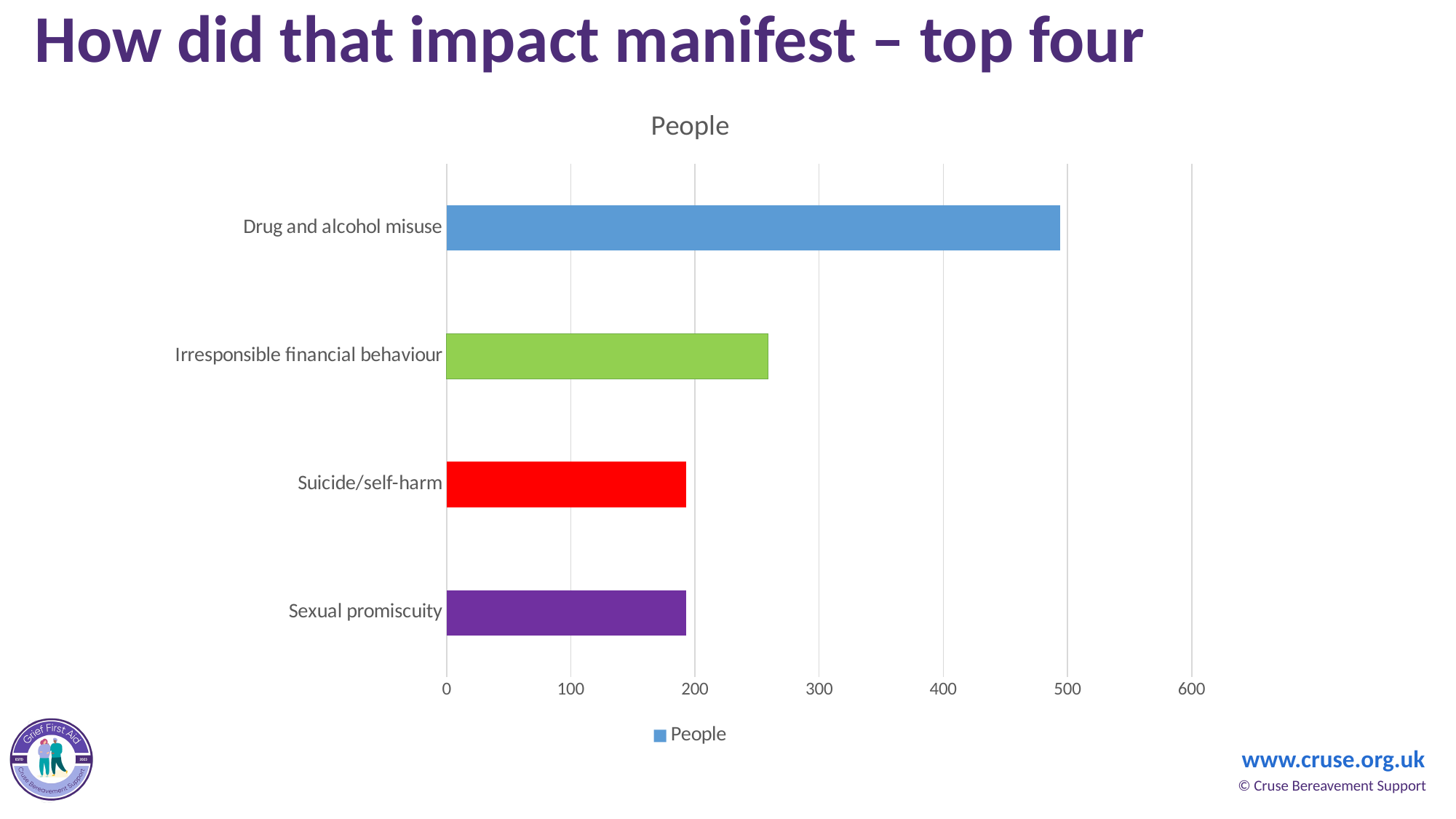
Which is larger, the value for Drug and alcohol misuse or the value for Irresponsible financial behaviour? Drug and alcohol misuse How many categories are plotted in the chart? 4 Is the value for Drug and alcohol misuse greater or less than 400? greater How many series does the legend list? 1 Is the value for Irresponsible financial behaviour greater or less than 300? less Which is larger, the value for Irresponsible financial behaviour or the value for Suicide/self-harm? Irresponsible financial behaviour What kind of chart is shown on the slide? bar chart Is the value for Irresponsible financial behaviour greater or less than 200? greater What colour is the bar for Suicide/self-harm? red What is the title of the chart? People Which category has the highest value? Drug and alcohol misuse